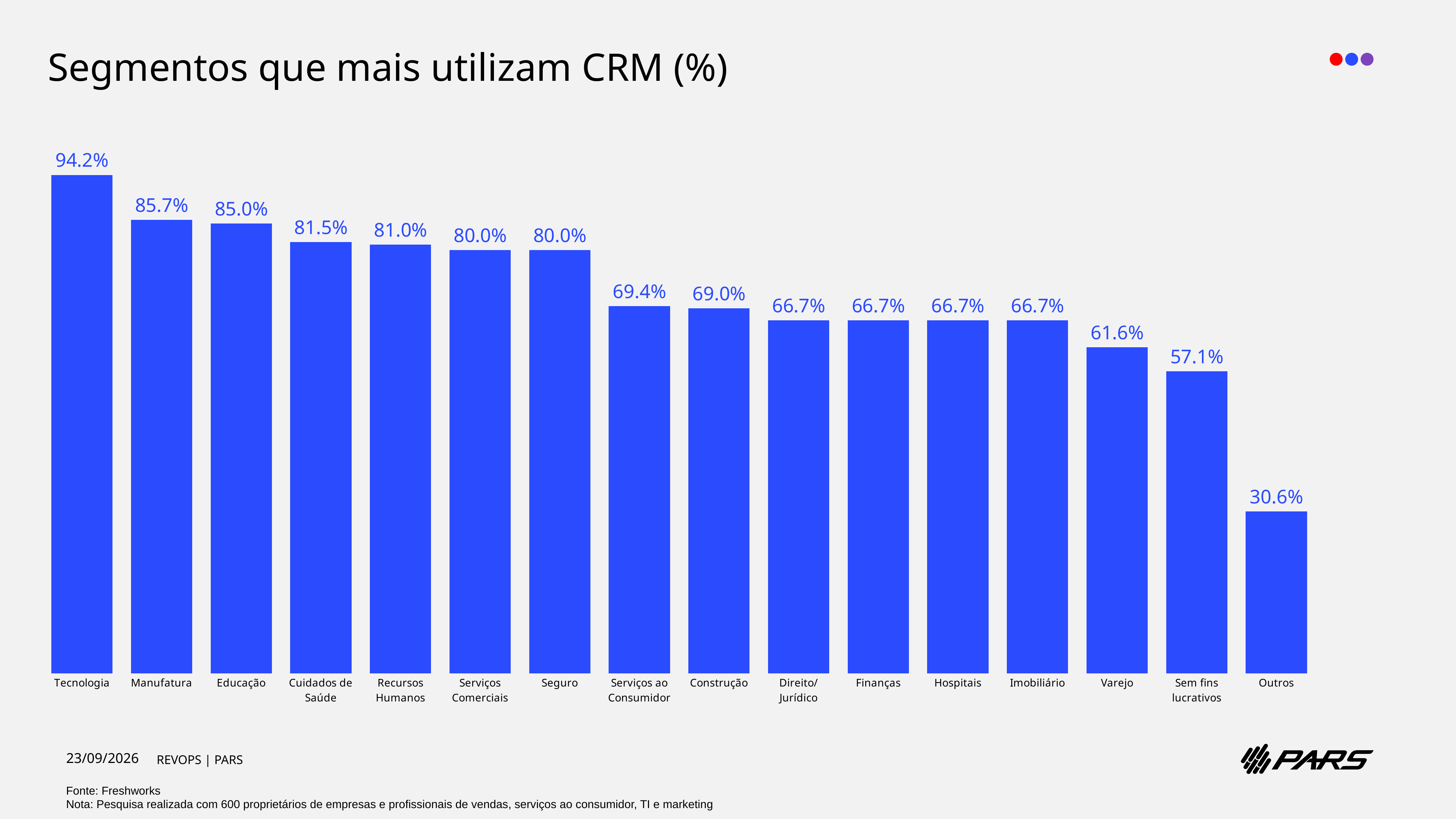
What is the value for Tecnologia? 94.2% What is the value for Serviços ao Consumidor? 69.4% Which is larger, Cuidados de Saúde or Construção? Cuidados de Saúde What is the difference between Manufatura and Educação? 0.7% What is the value for Varejo? 61.6% What is the title of the chart? Segmentos que mais utilizam CRM (%) Which segment has the highest value? Tecnologia How many segments are shown in the chart? 16 What is the difference between Tecnologia and Outros? 63.6% What kind of chart is shown on the slide? Bar chart Which segment has the lowest value? Outros Do the values rise or fall from left to right along the x axis? Fall